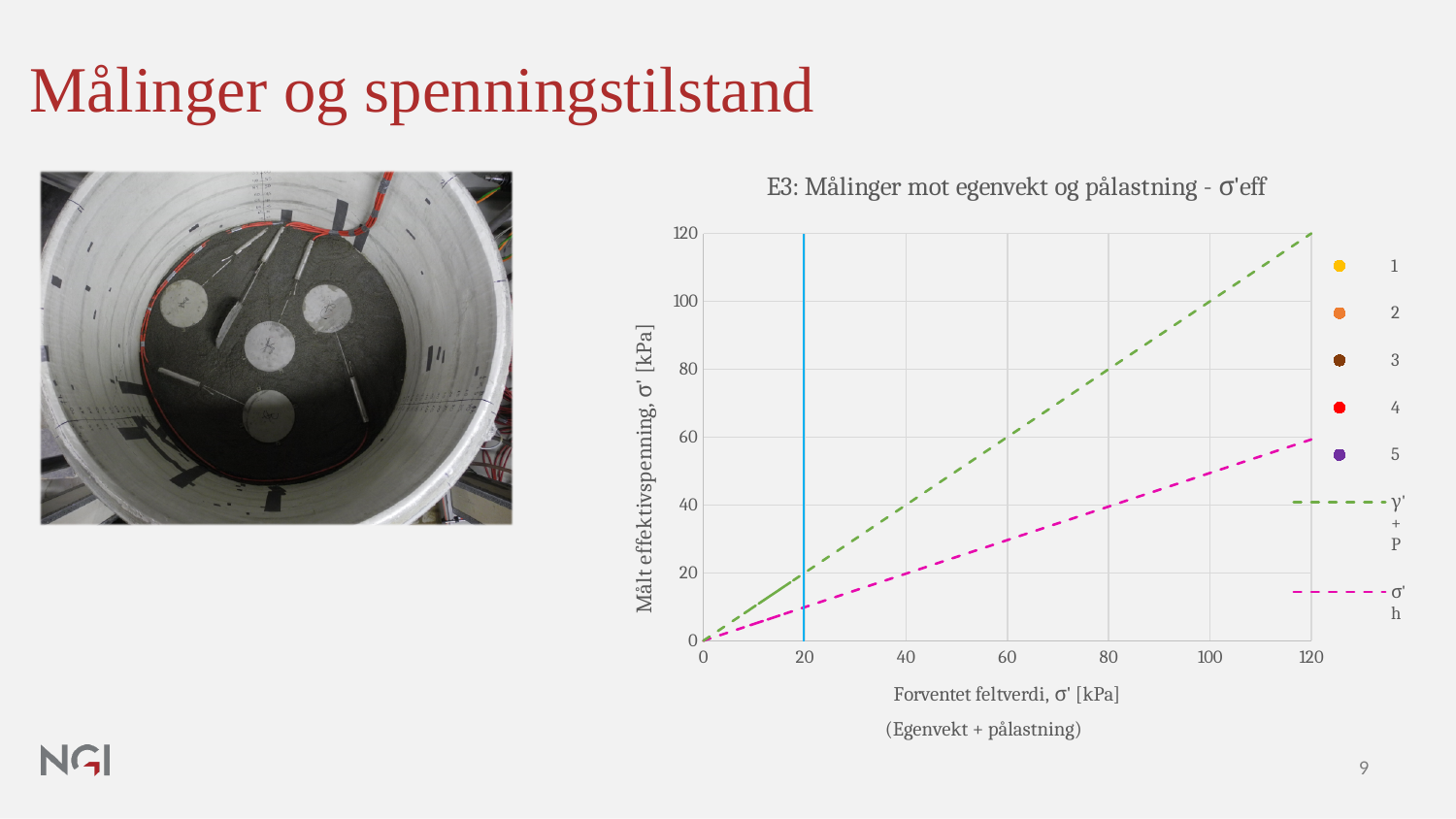
Do the dashed lines rise or fall as Forventet feltverdi increases? rise What is the highest value shown on the x axis? 120 Is the value of the γ'+P line at a Forventet feltverdi of 40 kPa greater or less than 20? greater Is the value of the σ'h line at a Forventet feltverdi of 120 kPa greater or less than 40? greater How many entries does the chart legend list? 7 What kind of chart is shown on the slide? line chart At a Forventet feltverdi of 100 kPa, which line is higher, γ'+P or σ'h? γ'+P What is the label of the y axis? Målt effektivspenning, σ' [kPa] What value does the γ'+P line reach at a Forventet feltverdi of 120 kPa? 120 What is the title of the chart? E3: Målinger mot egenvekt og pålastning - σ'eff Is the value of the σ'h line at a Forventet feltverdi of 120 kPa greater or less than 80? less At what x-axis value is the vertical blue line drawn? 20